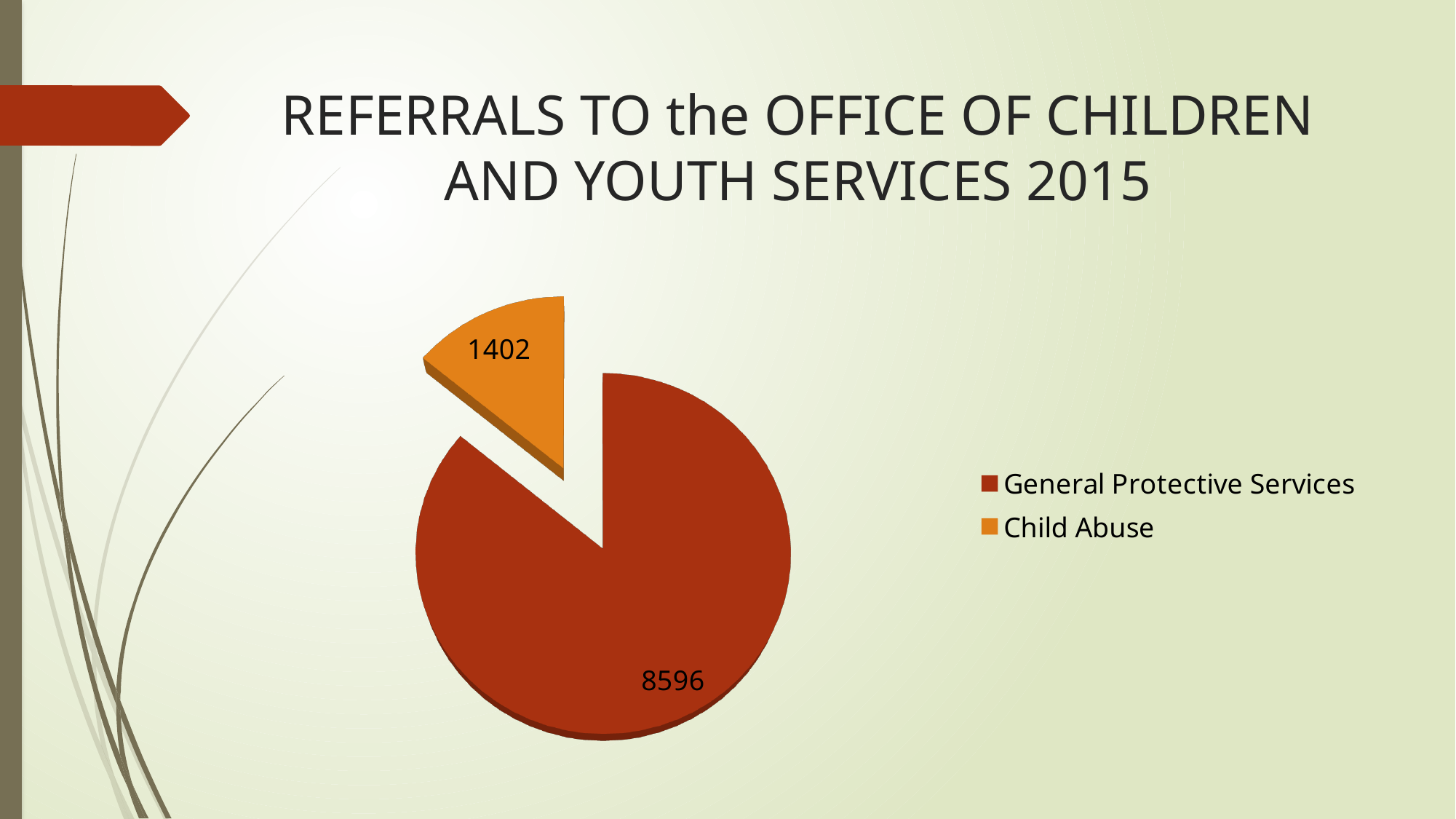
How many referrals were for Child Abuse? 1402 What is the total number of referrals shown in the pie chart? 9998 What kind of chart is shown on the slide? pie chart Which category has the smallest slice of the pie? Child Abuse Which is larger, the number of General Protective Services referrals or Child Abuse referrals? General Protective Services How many categories does the pie chart show? 2 Which category has the largest slice of the pie? General Protective Services What colour is the Child Abuse slice? orange How many entries does the legend list? 2 What is the title of the slide containing the chart? REFERRALS TO the OFFICE OF CHILDREN AND YOUTH SERVICES 2015 How many referrals were for General Protective Services? 8596 What is the difference between the General Protective Services and Child Abuse referrals? 7194